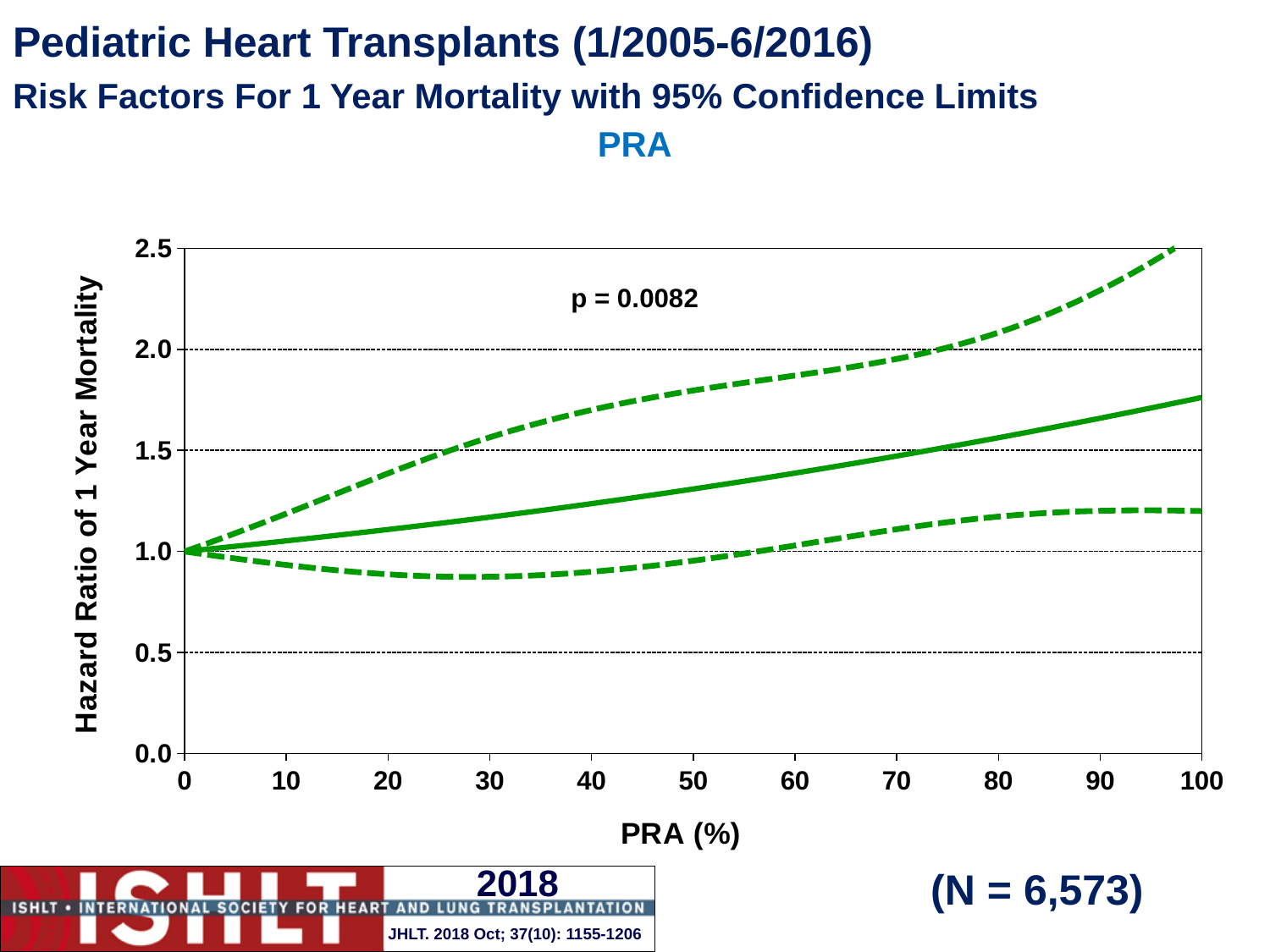
Does the solid hazard ratio line rise or fall as PRA increases from 0% to 100%? rise What kind of chart is shown on the slide? line chart What is the hazard ratio of 1 year mortality at a PRA of 0%? 1.0 Is the hazard ratio (solid line) at a PRA of 50% greater or less than 1.5? less Is the upper 95% confidence limit at a PRA of 100% greater or less than 2.0? greater Is the lower 95% confidence limit at a PRA of 30% greater or less than 1.0? less What sample size (N) is shown on the slide? N = 6,573 What p-value is printed on the chart? p = 0.0082 How many lines are plotted on the chart? 3